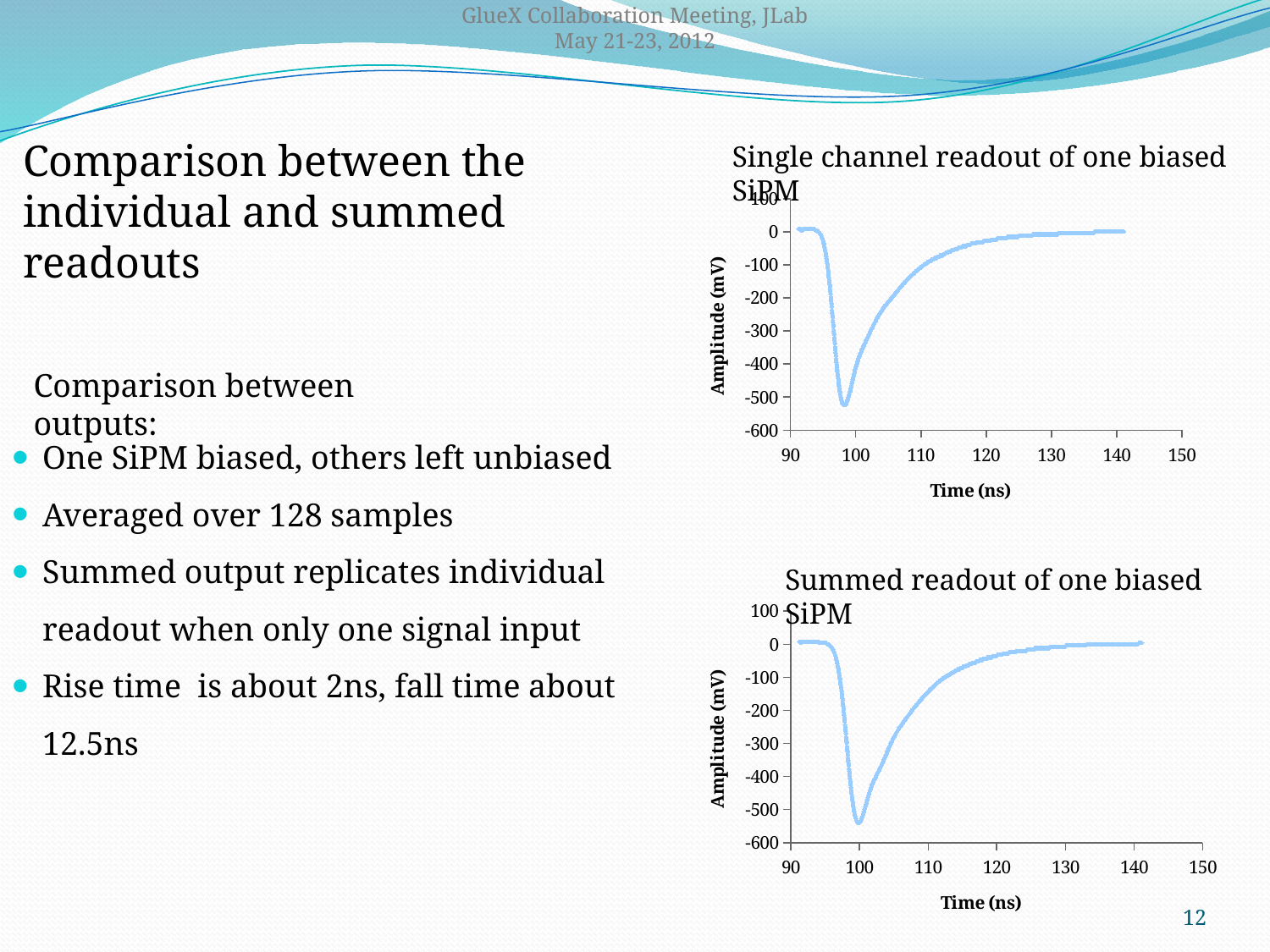
In the 'Summed readout of one biased SiPM' chart, is the minimum amplitude greater or less than -500? less In the 'Summed readout of one biased SiPM' chart, what is the label of the y axis? Amplitude (mV) What kind of chart is the 'Summed readout of one biased SiPM' chart? line chart In the 'Summed readout of one biased SiPM' chart, do the amplitude values rise or fall between 95 ns and 100 ns? fall In the 'Single channel readout of one biased SiPM' chart, is the minimum amplitude greater or less than -500? less How many charts are shown on the slide? 2 In the 'Single channel readout of one biased SiPM' chart, what is the label of the x axis? Time (ns) What kind of chart is the 'Single channel readout of one biased SiPM' chart? line chart In the 'Single channel readout of one biased SiPM' chart, is the amplitude at 120 ns greater or less than -100? greater In the 'Single channel readout of one biased SiPM' chart, do the amplitude values rise or fall between 100 ns and 140 ns? rise In the 'Summed readout of one biased SiPM' chart, what is the lowest value shown on the y axis? -600